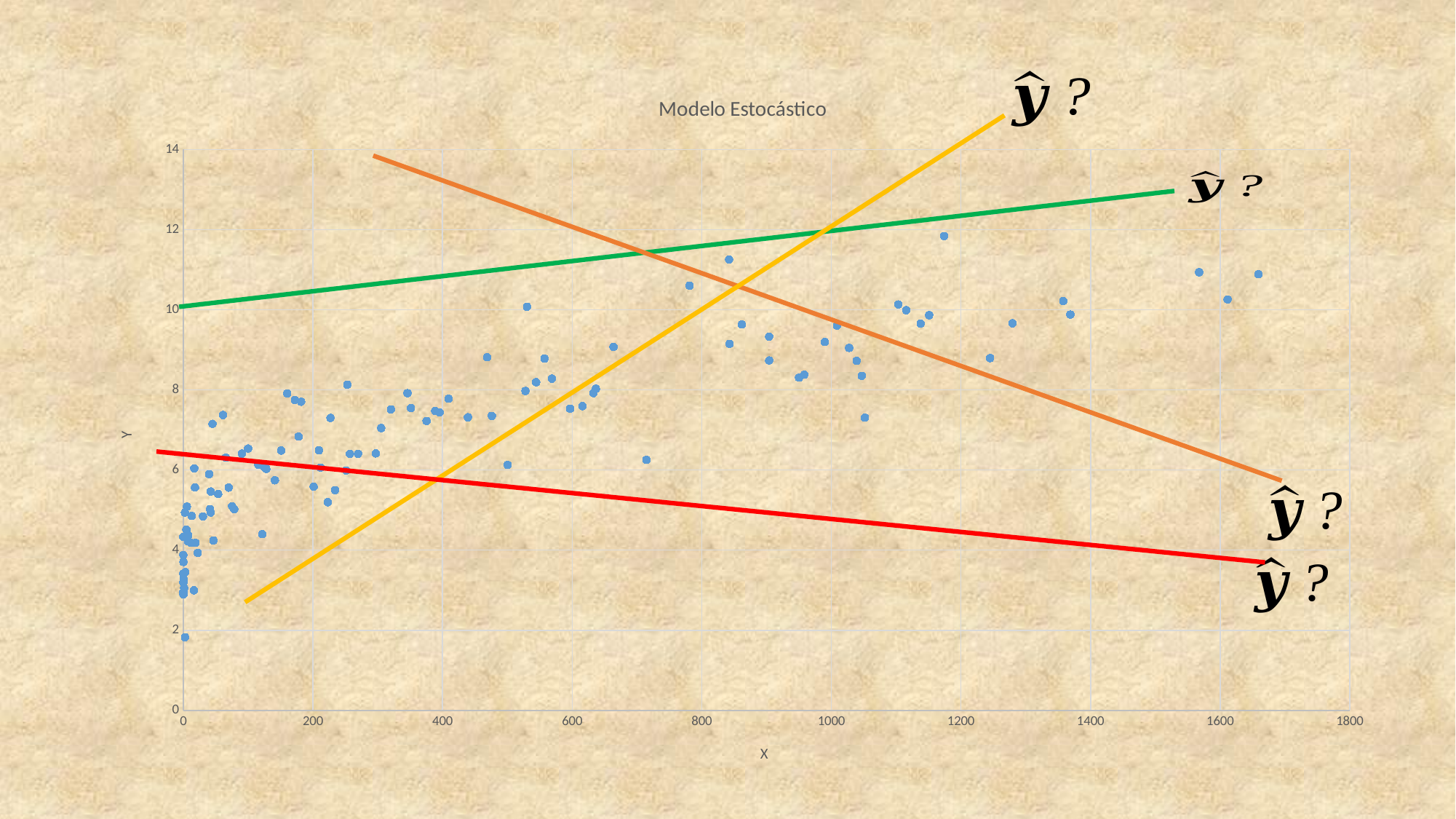
What kind of chart is shown on the slide? scatter chart What is the title of the chart? Modelo Estocástico How many straight coloured lines are drawn over the scatter points? 4 Do the plotted Y values generally rise or fall as X increases? rise Is the largest plotted Y value greater or less than 14? less Is the largest plotted X value greater or less than 1800? less Is the lowest plotted Y value greater or less than 4? less